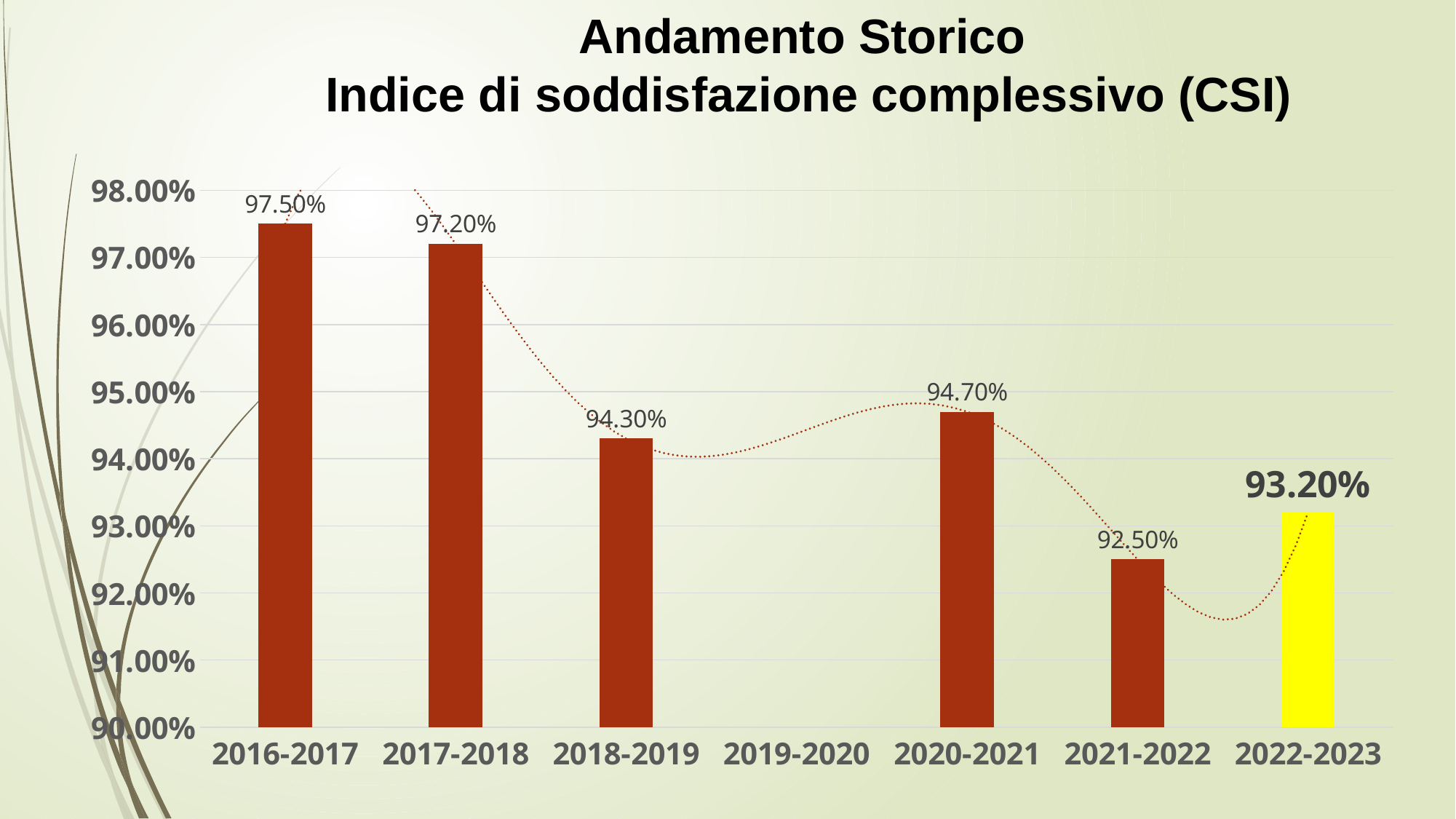
What is the difference between the CSI values for 2016-2017 and 2021-2022? 5.00% How many year categories are shown on the x axis? 7 Is the value for 2021-2022 greater or less than 93.00%? less What is the difference between the CSI values for 2022-2023 and 2021-2022? 0.70% Which year has the lowest CSI value among those with a bar? 2021-2022 Which is larger, the CSI value for 2018-2019 or for 2020-2021? 2020-2021 What is the CSI value for 2020-2021? 94.70% What is the CSI value for 2022-2023? 93.20% Which year category has no bar plotted? 2019-2020 What is the CSI value for 2016-2017? 97.50% Which year has the highest CSI value? 2016-2017 What kind of chart is shown on the slide? bar chart